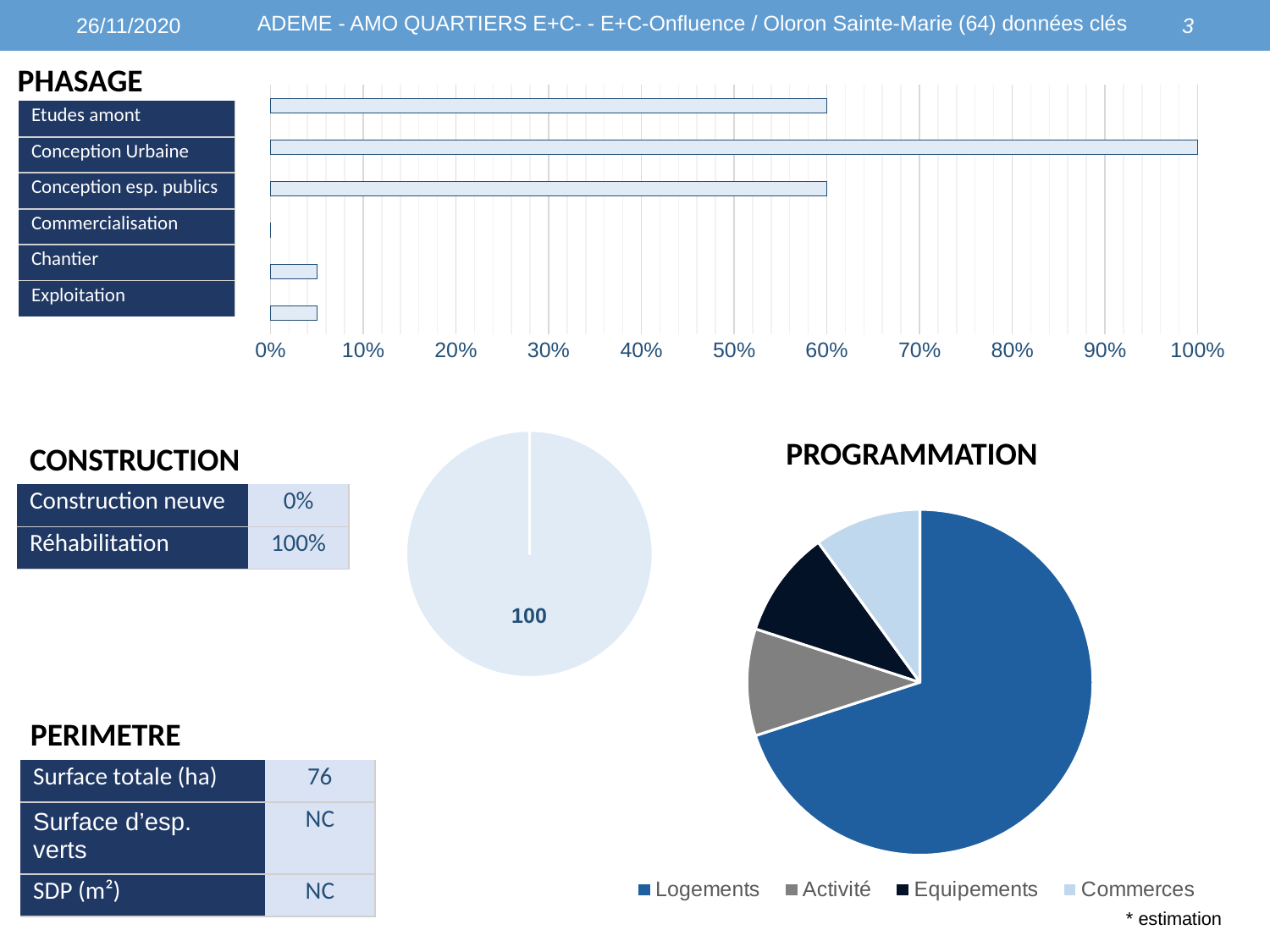
What kind of chart is the PROGRAMMATION chart? pie chart What data label is shown on the pie chart in the middle of the slide, next to the CONSTRUCTION table? 100 How many phases are plotted in the PHASAGE bar chart? 6 In the PHASAGE bar chart, which is larger: Conception Urbaine or Commercialisation? Conception Urbaine How many entries does the legend of the PROGRAMMATION pie chart list? 4 In the PHASAGE bar chart, is the value for Chantier greater or less than 10%? less In the PROGRAMMATION pie chart, which category has the largest slice? Logements In the PHASAGE bar chart, which phase has the longest bar? Conception Urbaine In the PHASAGE bar chart, which is larger: Etudes amont or Exploitation? Etudes amont In the PHASAGE bar chart, is the value for Etudes amont greater or less than 50%? greater What kind of chart is the PHASAGE chart at the top of the slide? bar chart In the PHASAGE bar chart, what value does the Conception Urbaine bar reach? 100%